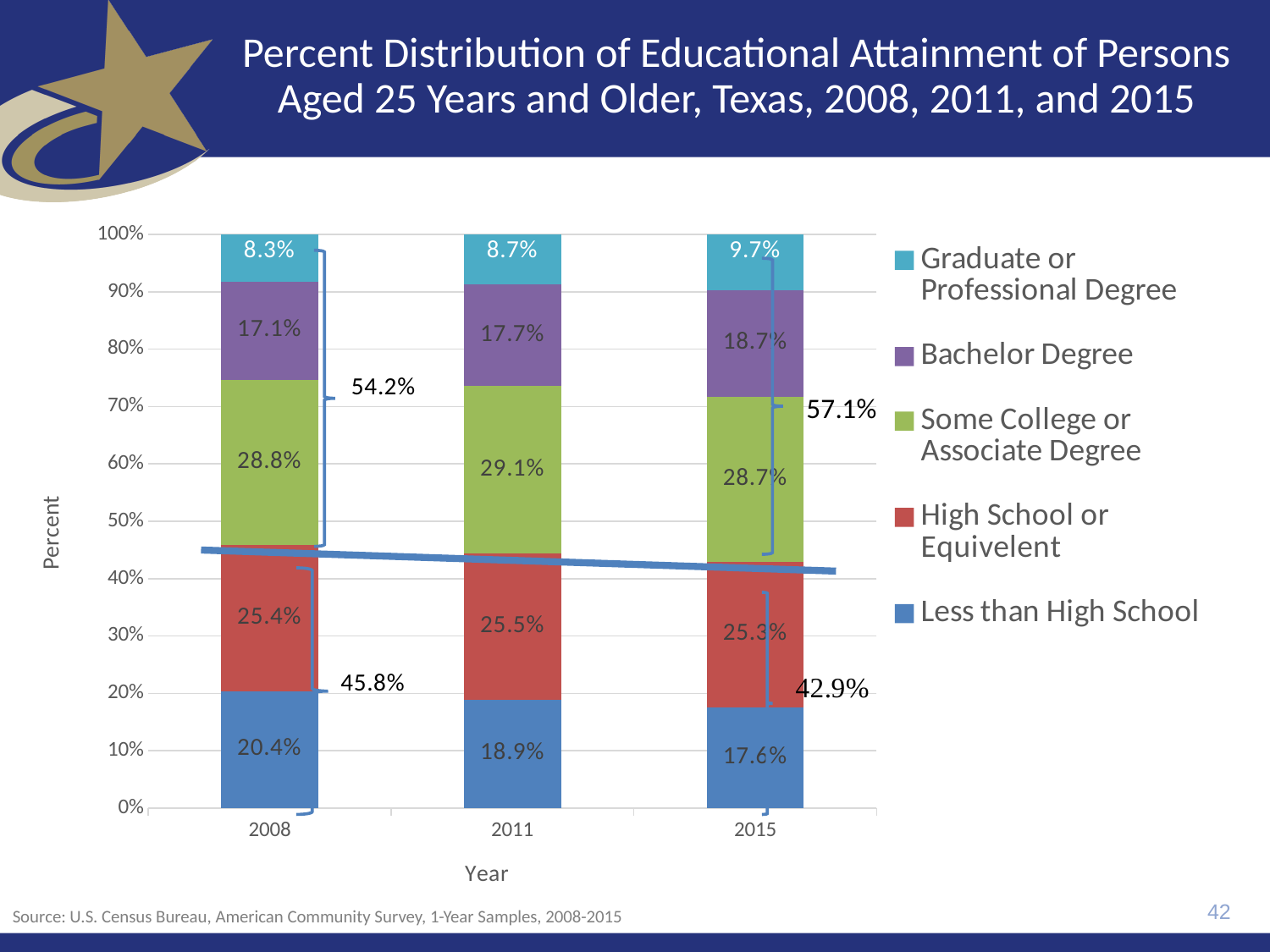
Which is larger: the Graduate or Professional Degree value in 2008 or in 2011? 2011 How many years are shown on the x axis? 3 Which year has the highest value for Bachelor Degree? 2015 What is the value for Some College or Associate Degree in 2011? 29.1% Does the Less than High School value rise or fall from 2008 to 2015? Fall What is the label on the y axis? Percent What is the value for Graduate or Professional Degree in 2015? 9.7% What is the value for Less than High School in 2008? 20.4% What is the difference between the Less than High School values for 2008 and 2015? 2.8% How many series does the legend list? 5 What kind of chart is shown on the slide? Stacked bar chart Which year has the lowest value for Less than High School? 2015